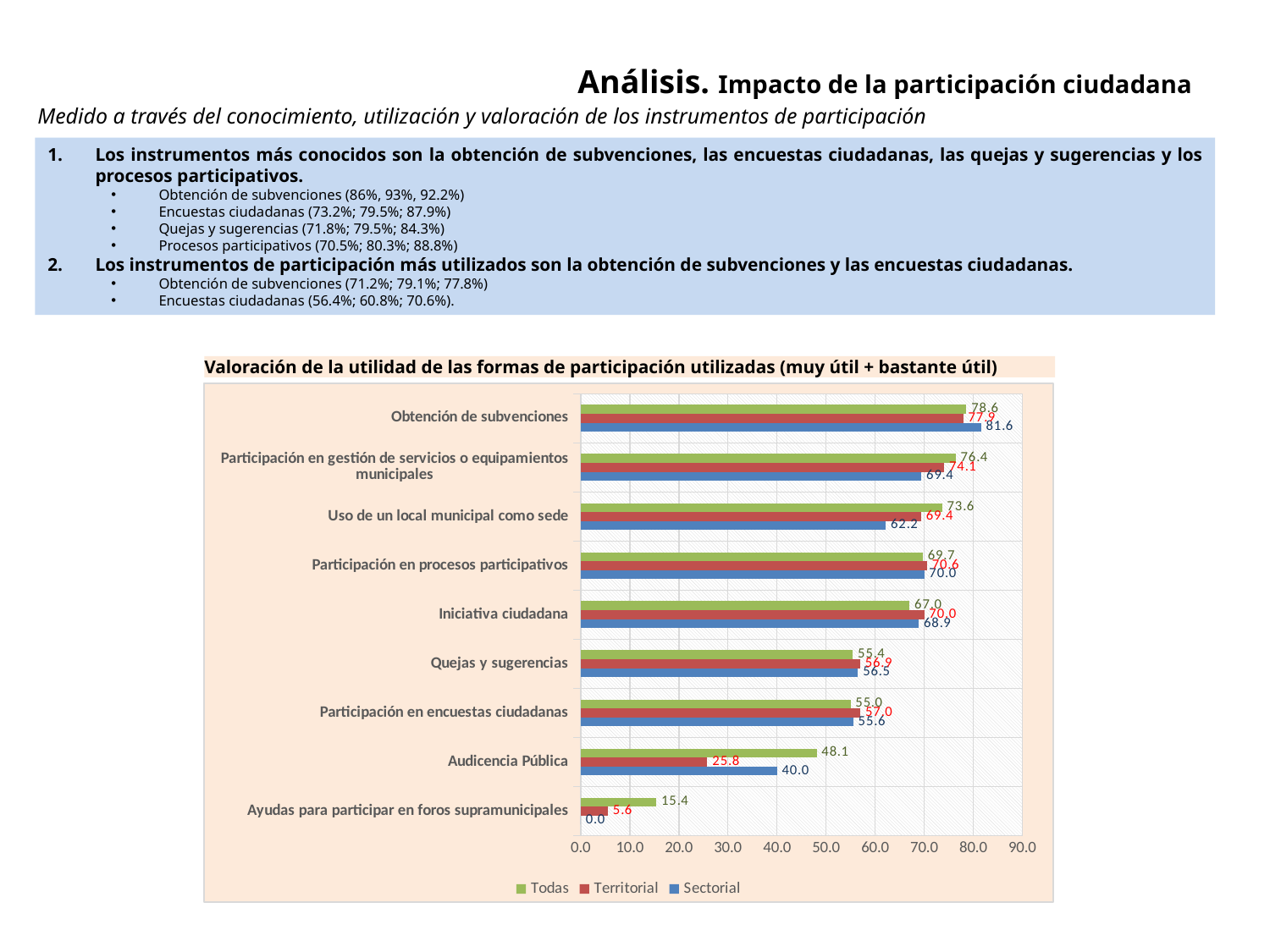
What type of chart is shown on the slide? bar chart Which series is shown in green in the chart? Todas What is the Sectorial value for Obtención de subvenciones? 81.6 How many categories are plotted in the chart? 9 How many series does the legend list in the chart? 3 For Uso de un local municipal como sede, which is larger: the Todas value or the Sectorial value? Todas Which category has the highest Sectorial value? Obtención de subvenciones Which category has the lowest Todas value? Ayudas para participar en foros supramunicipales What is the Sectorial value for Ayudas para participar en foros supramunicipales? 0.0 What is the Territorial value for Audicencia Pública? 25.8 What is the Todas value for Audicencia Pública? 48.1 What is the difference between the Todas and Territorial values for Audicencia Pública? 22.3